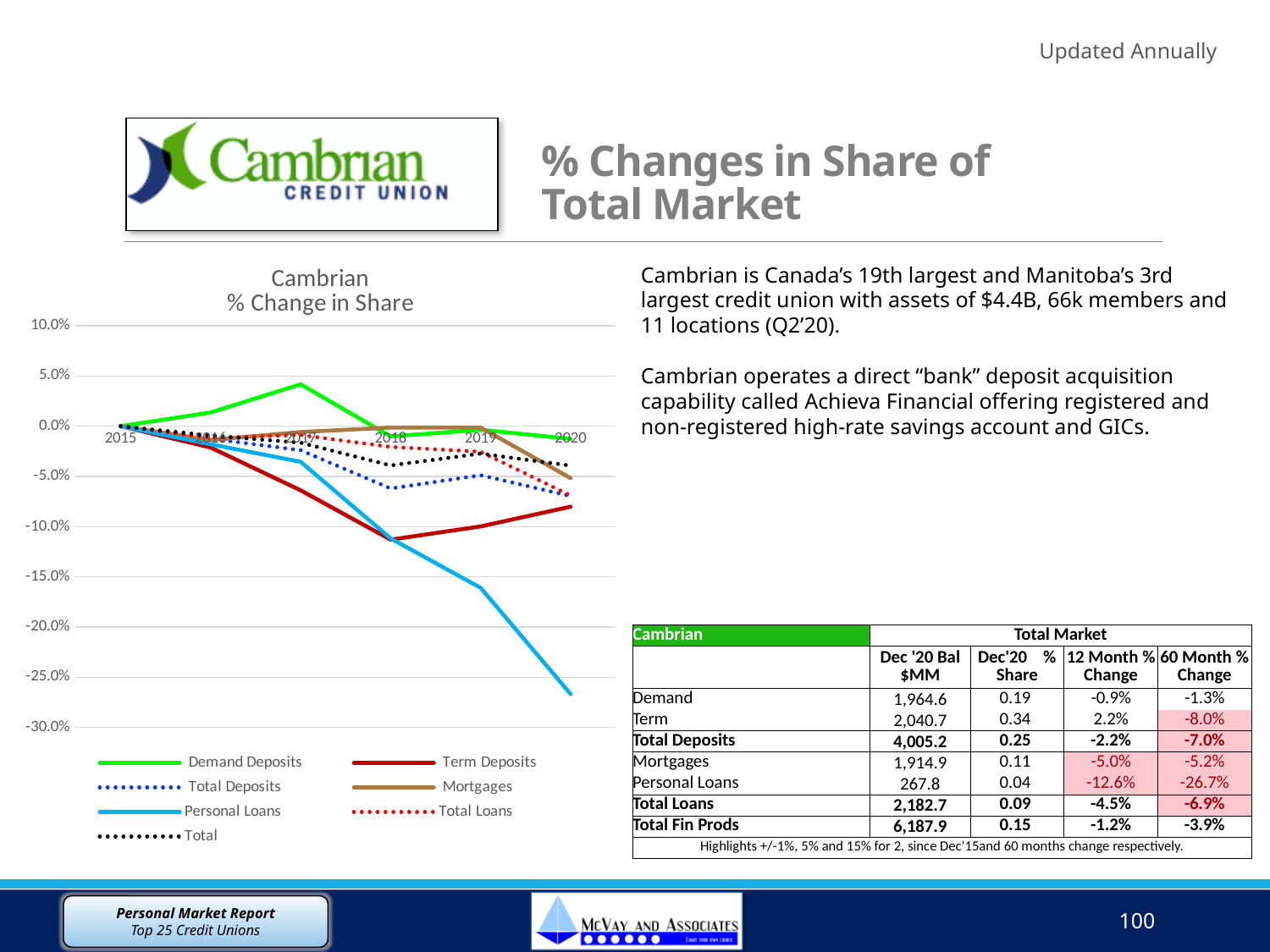
How many years are shown on the x axis of the "Cambrian % Change in Share" chart? 6 In the "Cambrian % Change in Share" chart, is the value for Demand Deposits in 2017 greater or less than 0.0%? greater In the "Cambrian % Change in Share" chart, which is larger in 2020: Term Deposits or Personal Loans? Term Deposits In the "Cambrian % Change in Share" chart, which series has the highest value in 2020? Demand Deposits In the "Cambrian % Change in Share" chart, is the value for Personal Loans in 2020 greater or less than -25.0%? less What kind of chart is the "Cambrian % Change in Share" chart? line chart In the "Cambrian % Change in Share" chart, which series has the lowest value in 2020? Personal Loans In the "Cambrian % Change in Share" chart, is the value for Personal Loans in 2019 greater or less than -15.0%? less What is the first year shown on the x axis of the "Cambrian % Change in Share" chart? 2015 How many series does the legend of the "Cambrian % Change in Share" chart list? 7 In the "Cambrian % Change in Share" chart, does the Personal Loans line rise or fall from 2015 to 2020? fall